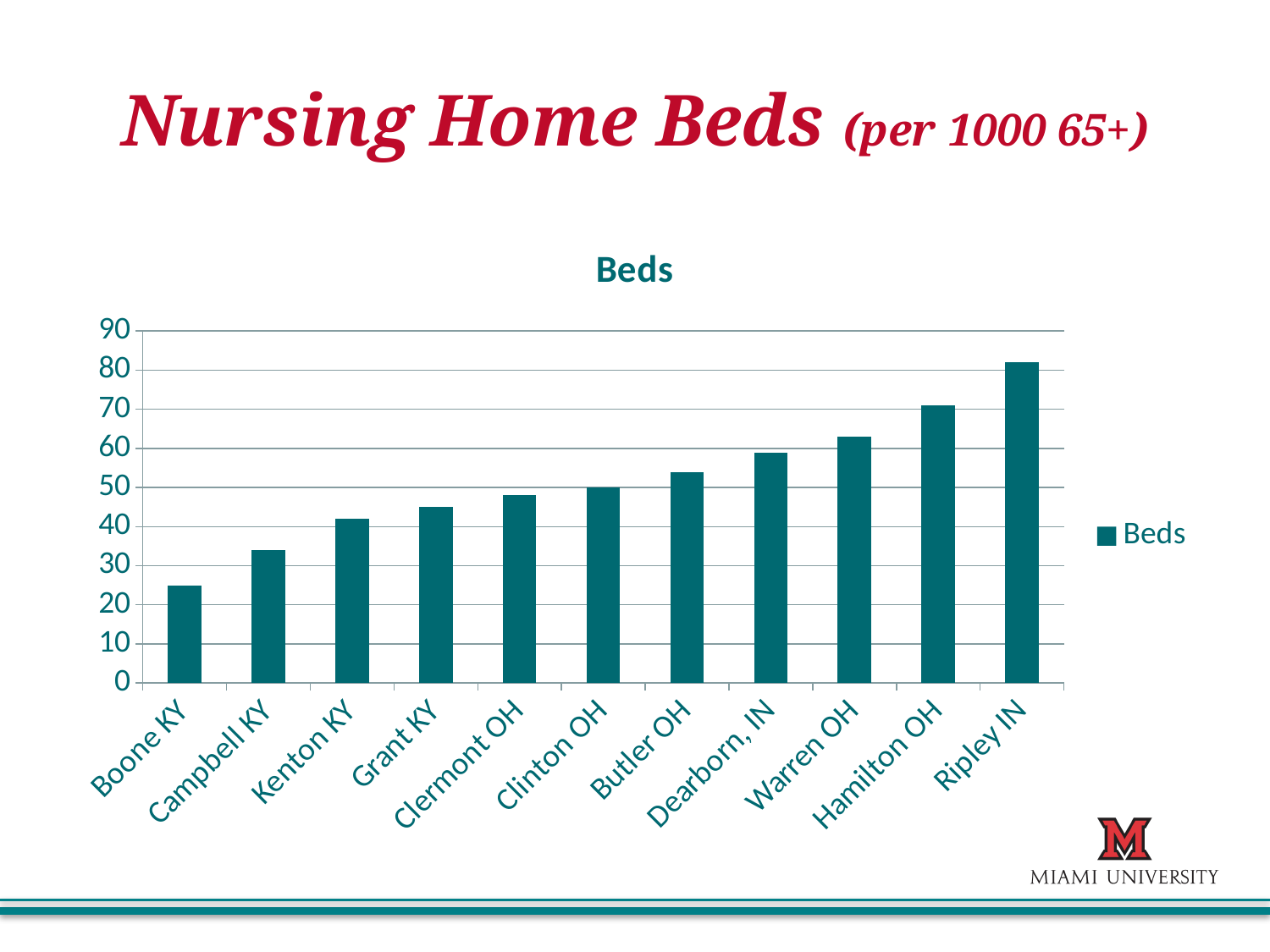
What is the title shown above the chart's plot area? Beds Do the values rise or fall moving from left to right along the x axis? rise Is the value for Boone KY greater or less than 30? less How many counties are shown on the x axis of the chart? 11 Is the value for Ripley IN greater or less than 80? greater How many series does the legend list? 1 Which county has the highest number of nursing home beds per 1000 65+? Ripley IN Is the value for Campbell KY greater or less than 40? less Which county has the lowest number of nursing home beds per 1000 65+? Boone KY What kind of chart is shown on the slide? bar chart Which has more nursing home beds per 1000 65+, Warren OH or Butler OH? Warren OH